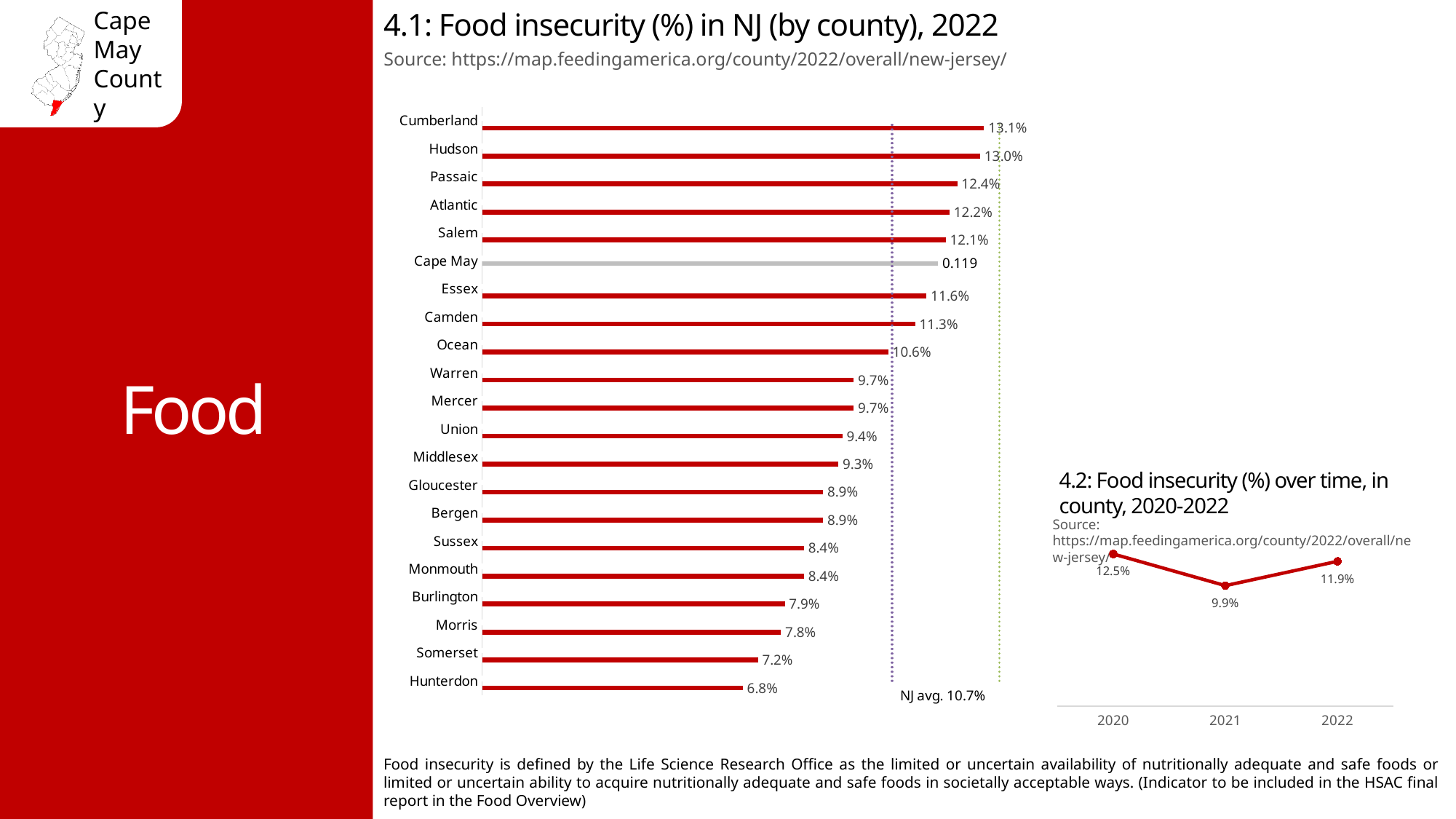
In chart 4.2 (Food insecurity over time in county, 2020-2022), what kind of chart is used? line chart In chart 4.1, which county has the lowest food insecurity percentage? Hunterdon In chart 4.2, what is the difference between the 2020 value and the 2021 value? 2.6% In chart 4.2, what is the food insecurity value for 2021? 9.9% In chart 4.1, which county has the highest food insecurity percentage? Cumberland In chart 4.1, what is the food insecurity value for Ocean? 10.6% In chart 4.1, what is the food insecurity value for Passaic? 12.4% In chart 4.1, which county has the larger value, Essex or Camden? Essex In chart 4.1, what NJ average value is labelled next to the dotted reference line? 10.7% In chart 4.1 (Food insecurity in NJ by county, 2022), what kind of chart is used? bar chart In chart 4.1, how many counties are shown? 21 In chart 4.1, what is the difference between Cumberland's value and Hunterdon's value? 6.3%